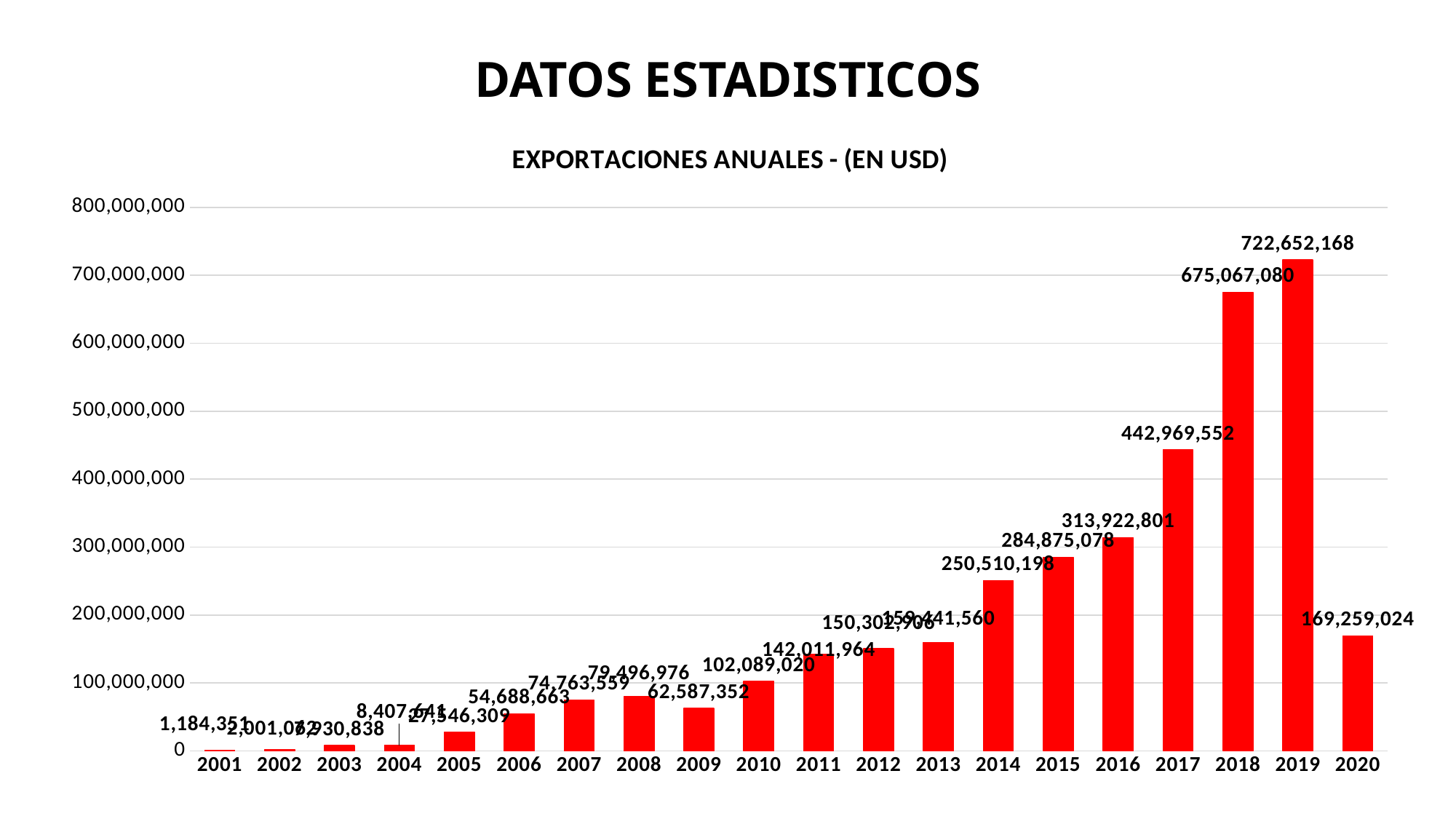
Which year has the larger export value, 2008 or 2009? 2008 What is the value of annual exports for 2019? 722,652,168 What is the difference between the 2019 and 2018 export values? 47,585,088 What kind of chart is shown on the slide? bar chart What is the title of the chart? EXPORTACIONES ANUALES - (EN USD) What is the value of annual exports for 2018? 675,067,080 Is the value for 2017 greater or less than 400,000,000? greater What is the value of annual exports for 2020? 169,259,024 What is the value of annual exports for 2010? 102,089,020 Which year has the highest annual exports? 2019 How many years are shown on the x axis of the chart? 20 Which year has the lowest annual exports? 2001